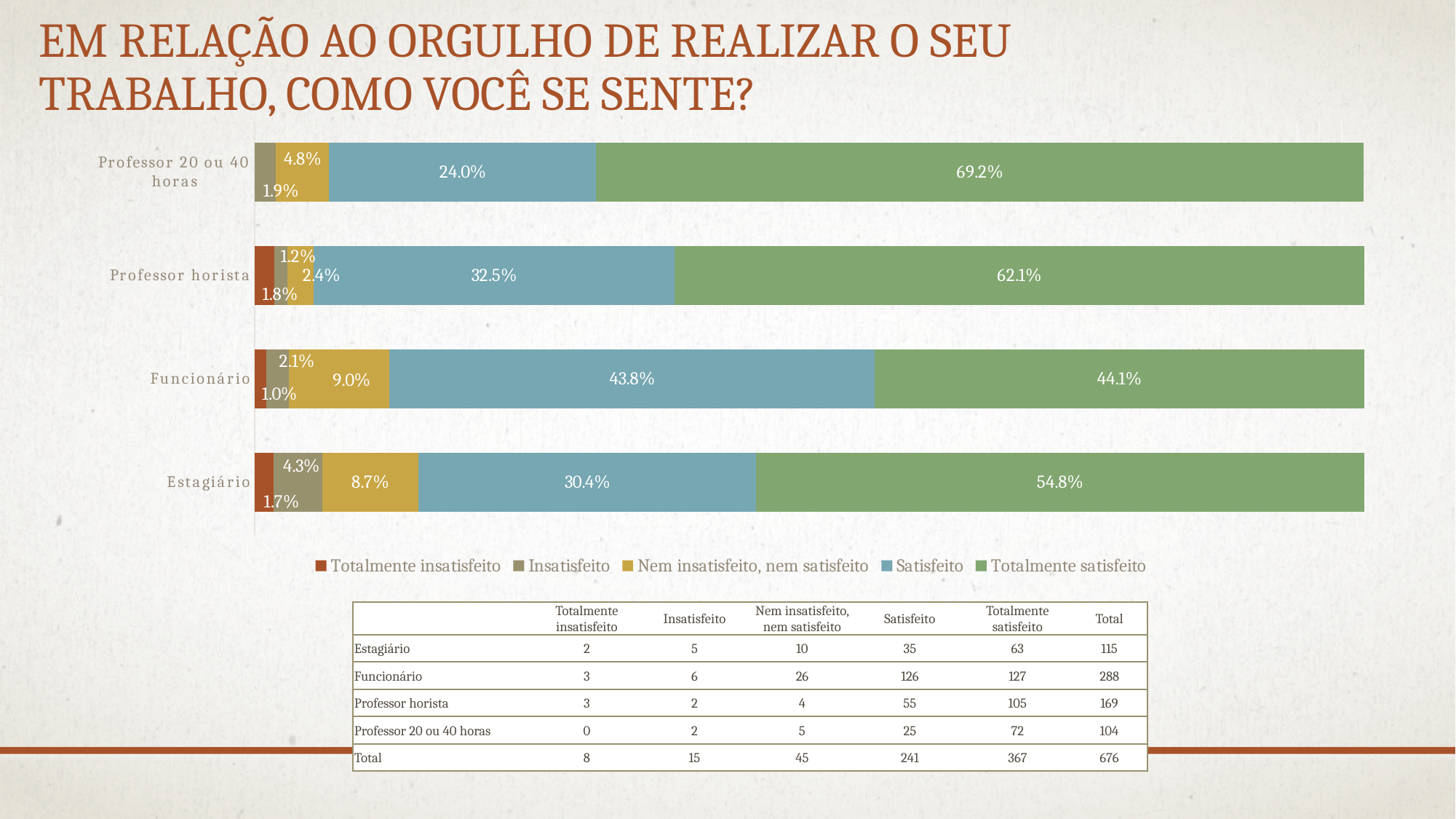
What is the value of the Totalmente satisfeito segment for Professor 20 ou 40 horas? 69.2% What kind of chart is shown on the slide? Stacked bar chart How many categories are shown on the chart? 4 What is the value of the Satisfeito segment for Professor horista? 32.5% For Funcionário, which is larger: the Satisfeito segment or the Totalmente satisfeito segment? Totalmente satisfeito What is the difference in percentage points between the Satisfeito values for Funcionário and Estagiário? 13.4 percentage points What colour represents Totalmente satisfeito in the legend? Green What is the value of the Satisfeito segment for Funcionário? 43.8% Which category has the highest Totalmente satisfeito percentage? Professor 20 ou 40 horas How many series does the legend list? 5 Which category has the lowest Totalmente satisfeito percentage? Funcionário What is the value of the Nem insatisfeito, nem satisfeito segment for Estagiário? 8.7%